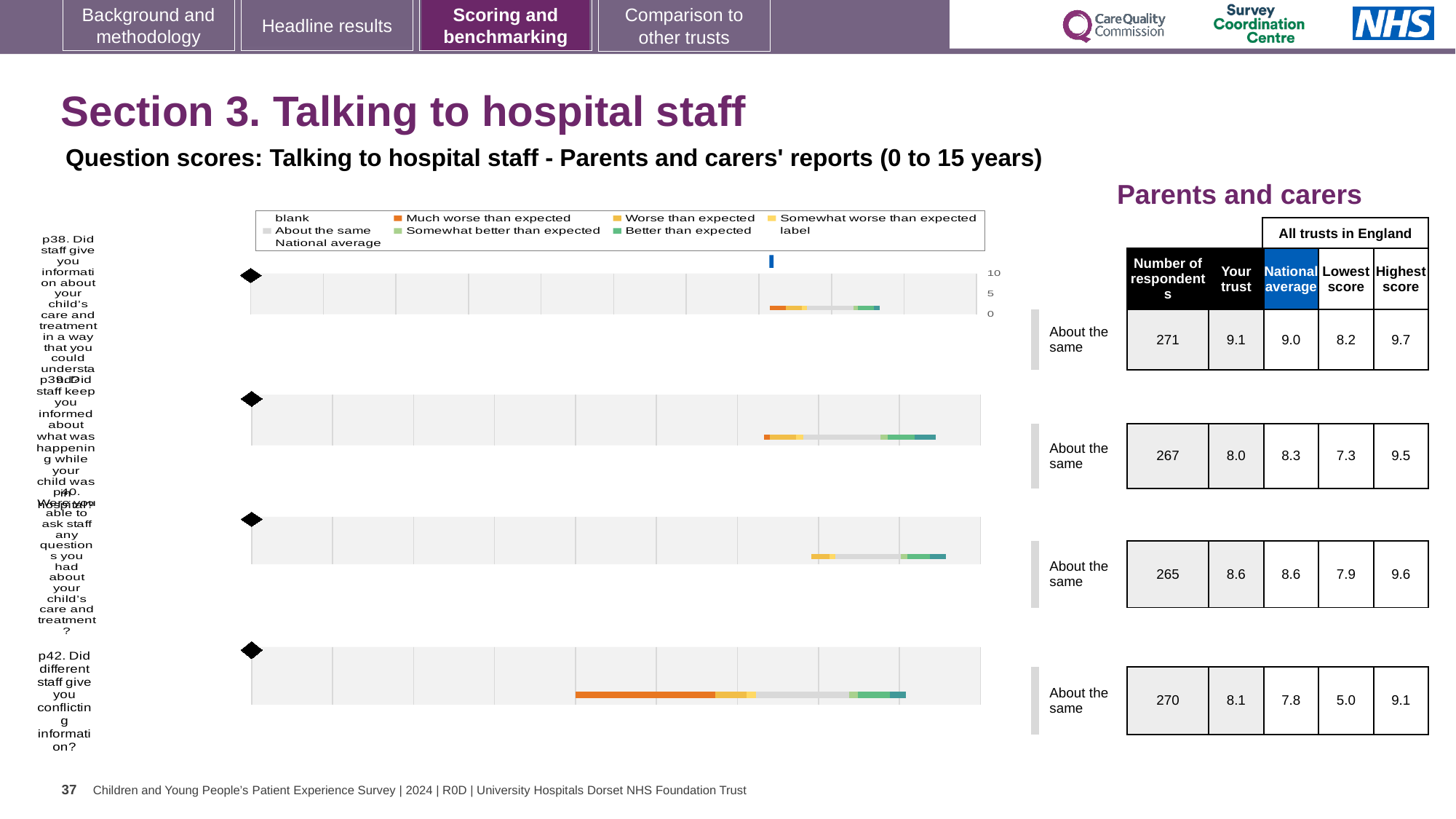
For question p42, which is larger: the 'Your trust' score or the national average? Your trust For question p39, what is the difference between the national average and the 'Your trust' score? 0.3 What benchmark category is shown for all four questions on the slide? About the same What is the lowest score among all trusts in England for question p42? 5.0 What is the highest score among all trusts in England for question p40 (Were you able to ask staff any questions you had about your child's care and treatment)? 9.6 What is the national average score for question p42 (Did different staff give you conflicting information)? 7.8 In the table next to the charts, how many respondents are listed for question p38 (Did staff give you information about your child's care and treatment in a way that you could understand)? 271 What is the 'Your trust' score for question p39 (Did staff keep you informed about what was happening while your child was in hospital)? 8.0 What kind of chart is used to show each question's benchmarking result? Bar chart How many question charts are shown on the slide? 4 Which of the four questions has the lowest 'Lowest score' across all trusts in England? p42 Which of the four questions has the highest 'Your trust' score? p38